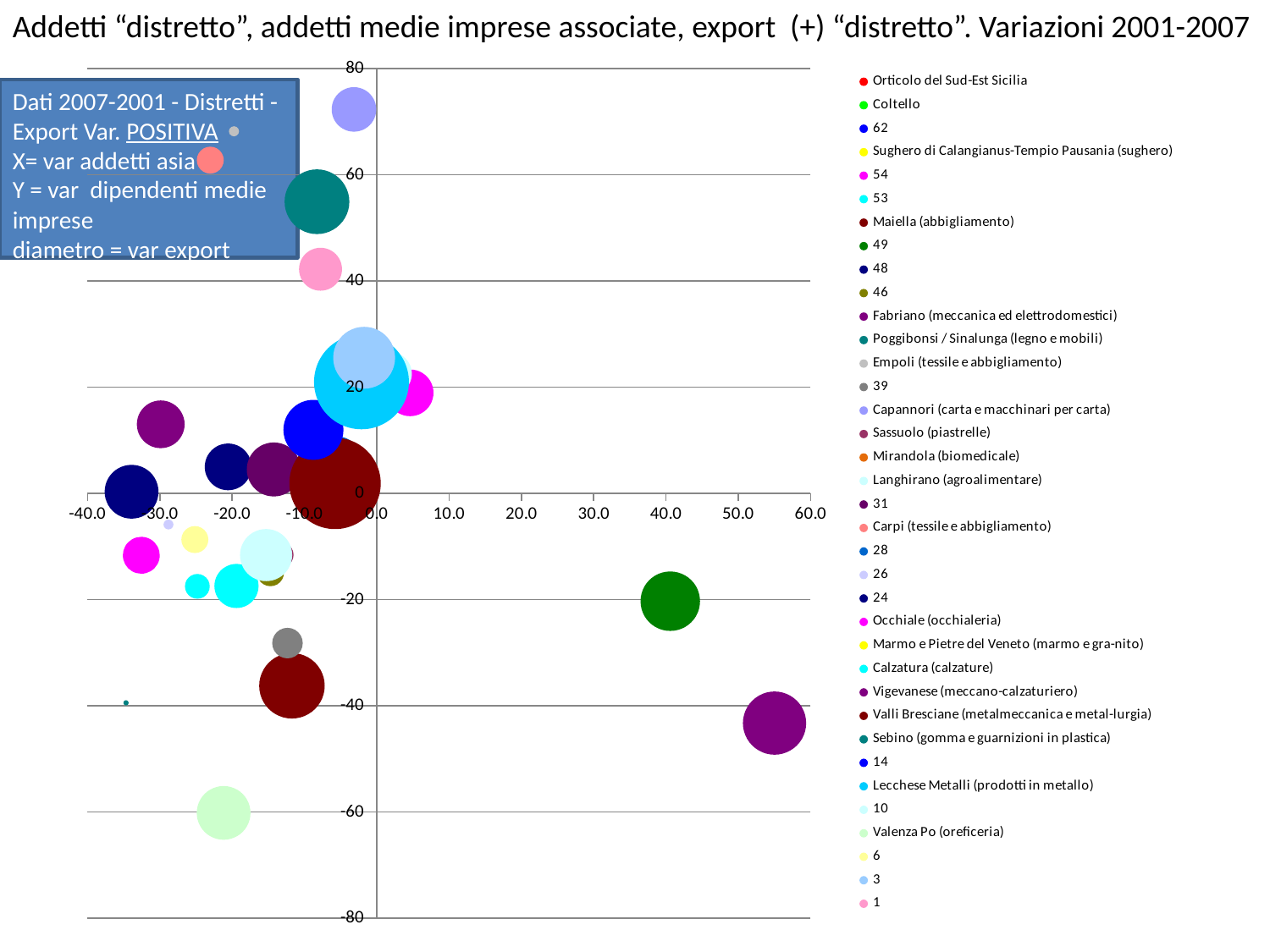
Which bubble has the highest y-axis value? Capannori (carta e macchinari per carta) What kind of chart is shown on the slide? Bubble chart How many entries does the chart legend list? 36 Is the y-axis value for Valenza Po (oreficeria) greater or less than -40? less Is the y-axis value for Capannori (carta e macchinari per carta) greater or less than 60? greater What is the title of the chart? Addetti "distretto", addetti medie imprese associate, export (+) "distretto". Variazioni 2001-2007 What colour is the bubble for Coltello in the legend? Green